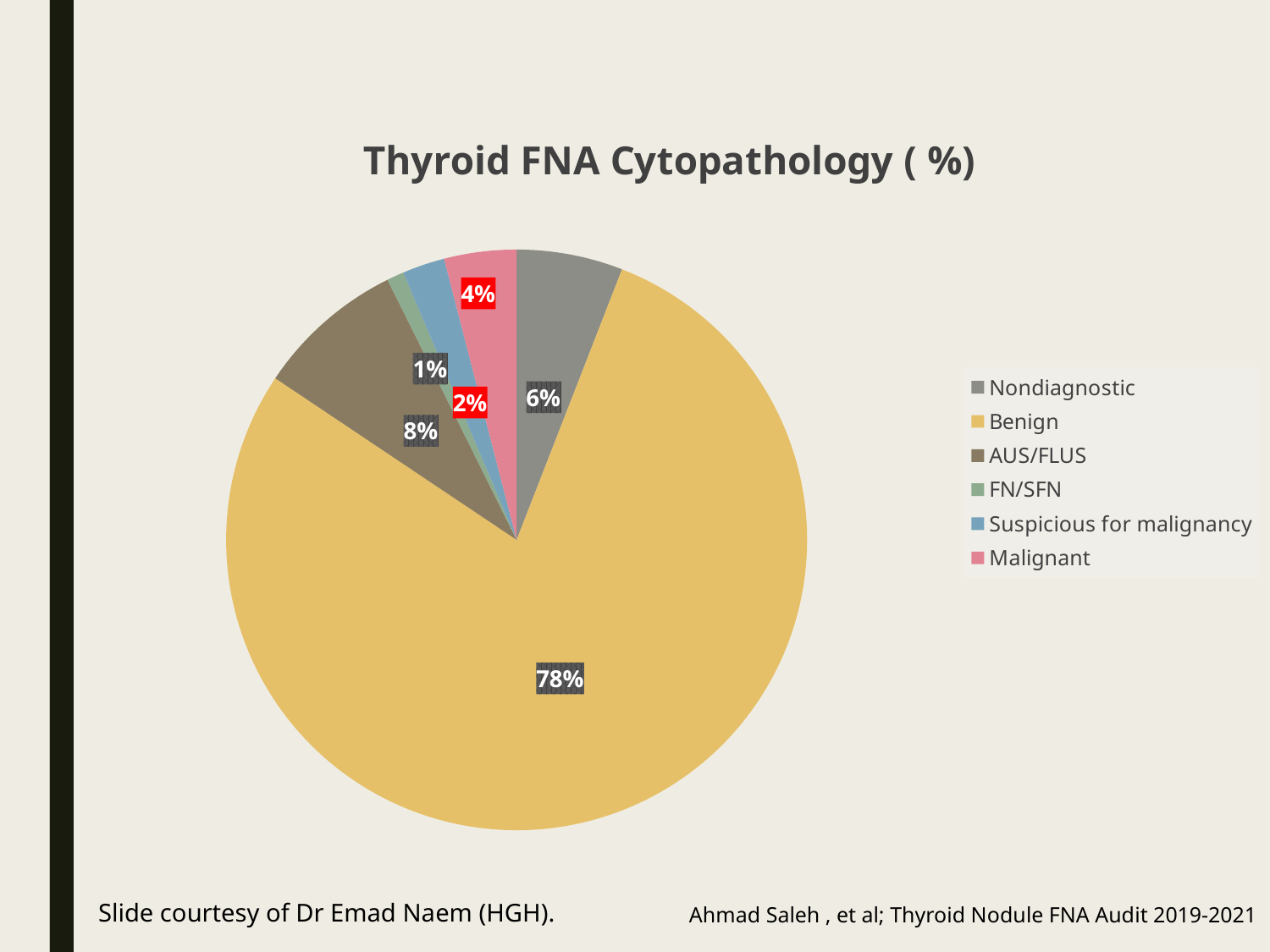
What is the difference in percentage points between Benign and AUS/FLUS? 70 What percentage of the pie is Malignant? 4% Which is larger, the share for Nondiagnostic or the share for Malignant? Nondiagnostic Which category has the largest share of the pie? Benign What percentage of the pie is AUS/FLUS? 8% What percentage of the pie is Benign? 78% What type of chart is shown on the slide? Pie chart How many categories does the legend list? 6 What percentage of the pie is Nondiagnostic? 6% What is the title of the chart? Thyroid FNA Cytopathology ( %) What percentage of the pie is Suspicious for malignancy? 2% Which category has the smallest share of the pie? FN/SFN